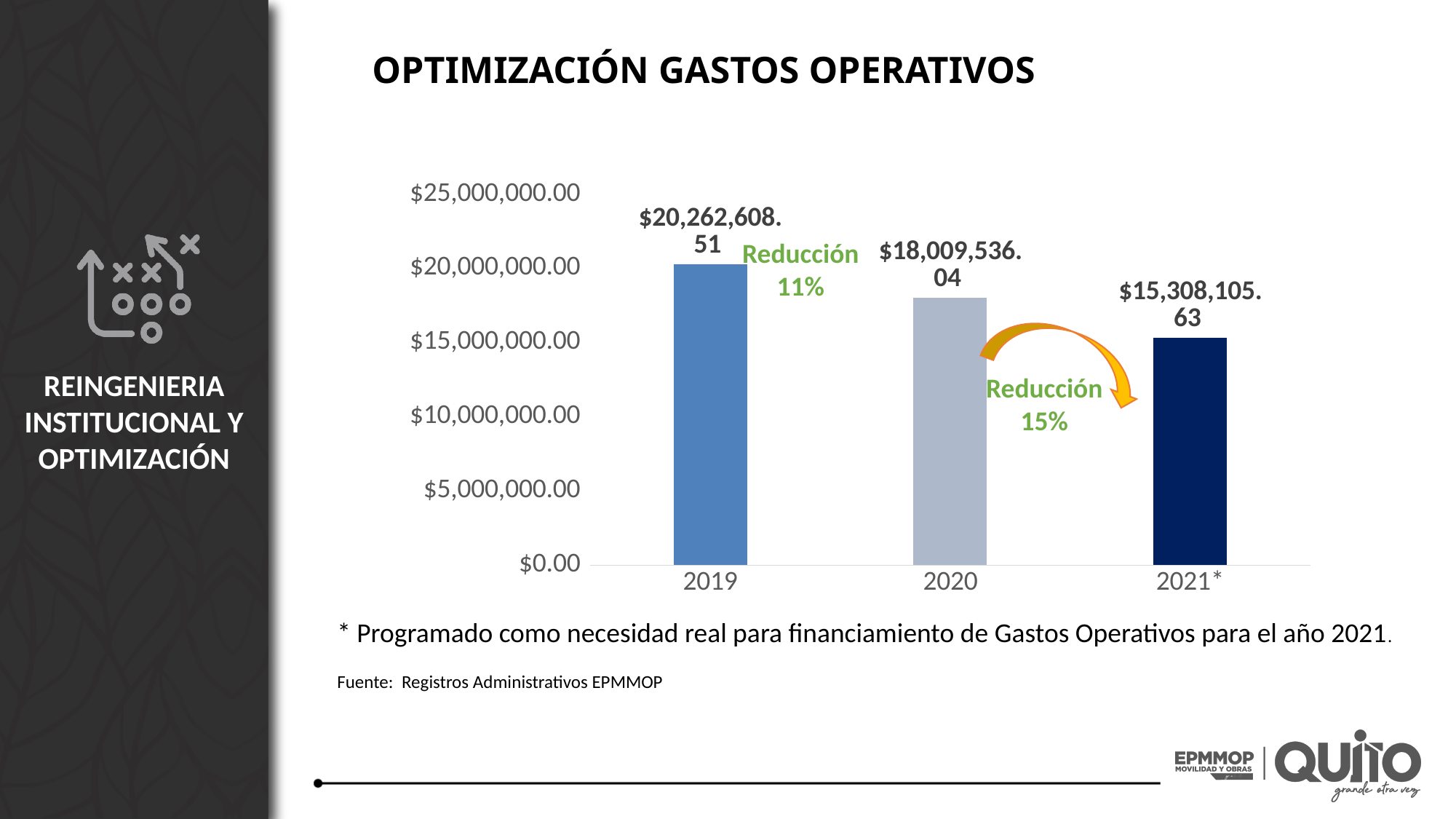
What is the value shown for 2019? $20,262,608.51 What kind of chart is shown on the slide? bar chart Which is larger, the value for 2020 or the value for 2021*? 2020 Which year has the highest value? 2019 What is the value shown for 2021*? $15,308,105.63 What percentage reduction is labelled between 2020 and 2021*? 15% Is the value for 2019 greater or less than $20,000,000.00? greater How many years are shown on the x axis? 3 Which year has the lowest value? 2021* What is the difference between the 2020 and 2021* values? $2,701,430.41 What is the difference between the 2019 and 2020 values? $2,253,072.47 What is the value shown for 2020? $18,009,536.04